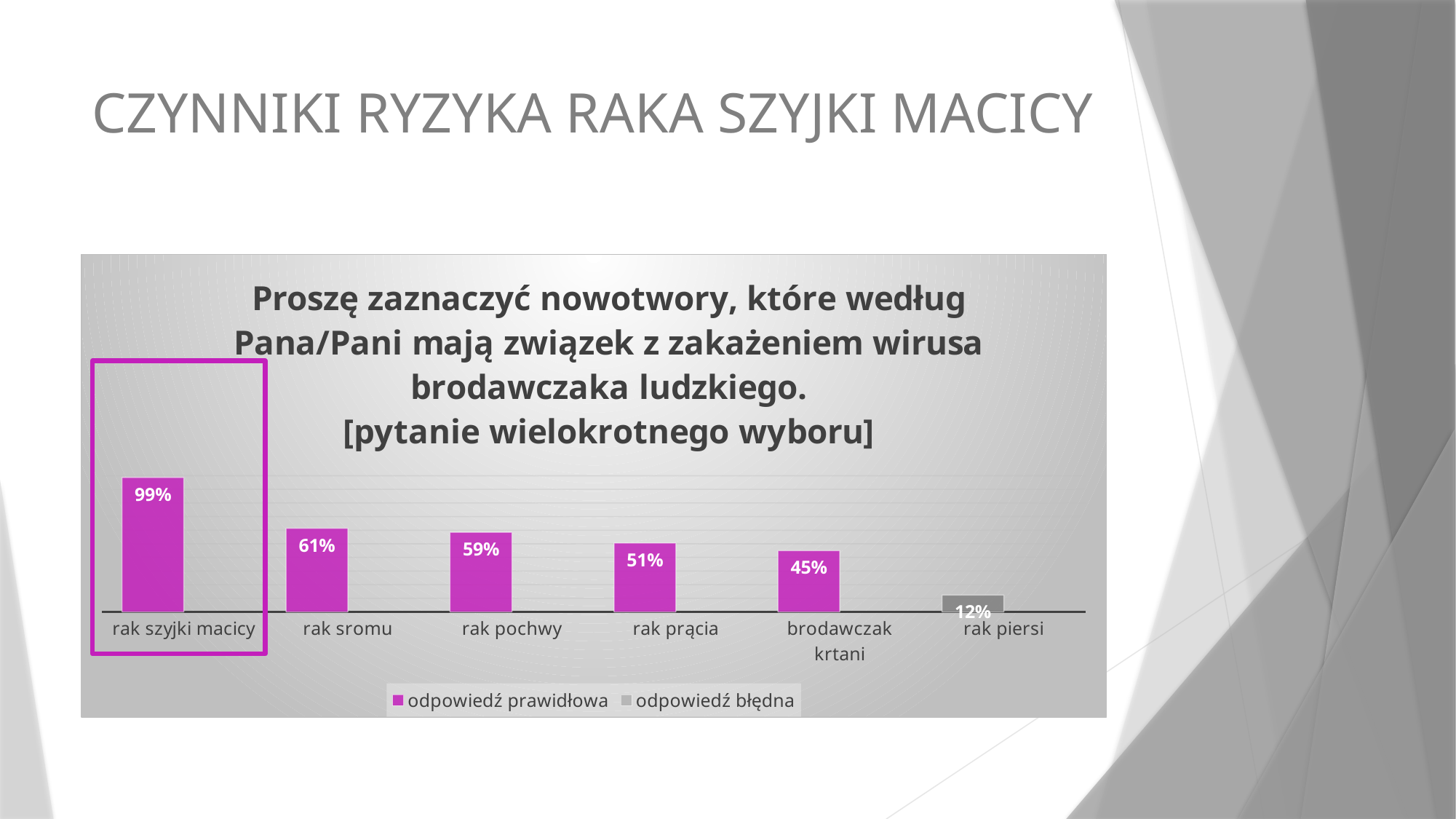
How many categories are shown on the x axis? 6 What is the value for rak piersi? 12% Which series does the bar for rak piersi belong to, according to the legend? odpowiedź błędna Which category has the lowest value? rak piersi What kind of chart is shown on the slide? bar chart Which category has the highest value? rak szyjki macicy What is the value for rak sromu? 61% What is the value for rak szyjki macicy? 99% What is the difference between the values for rak szyjki macicy and rak sromu? 38% How many series does the legend list? 2 Which is larger, the value for rak pochwy or the value for rak prącia? rak pochwy What is the value for brodawczak krtani? 45%